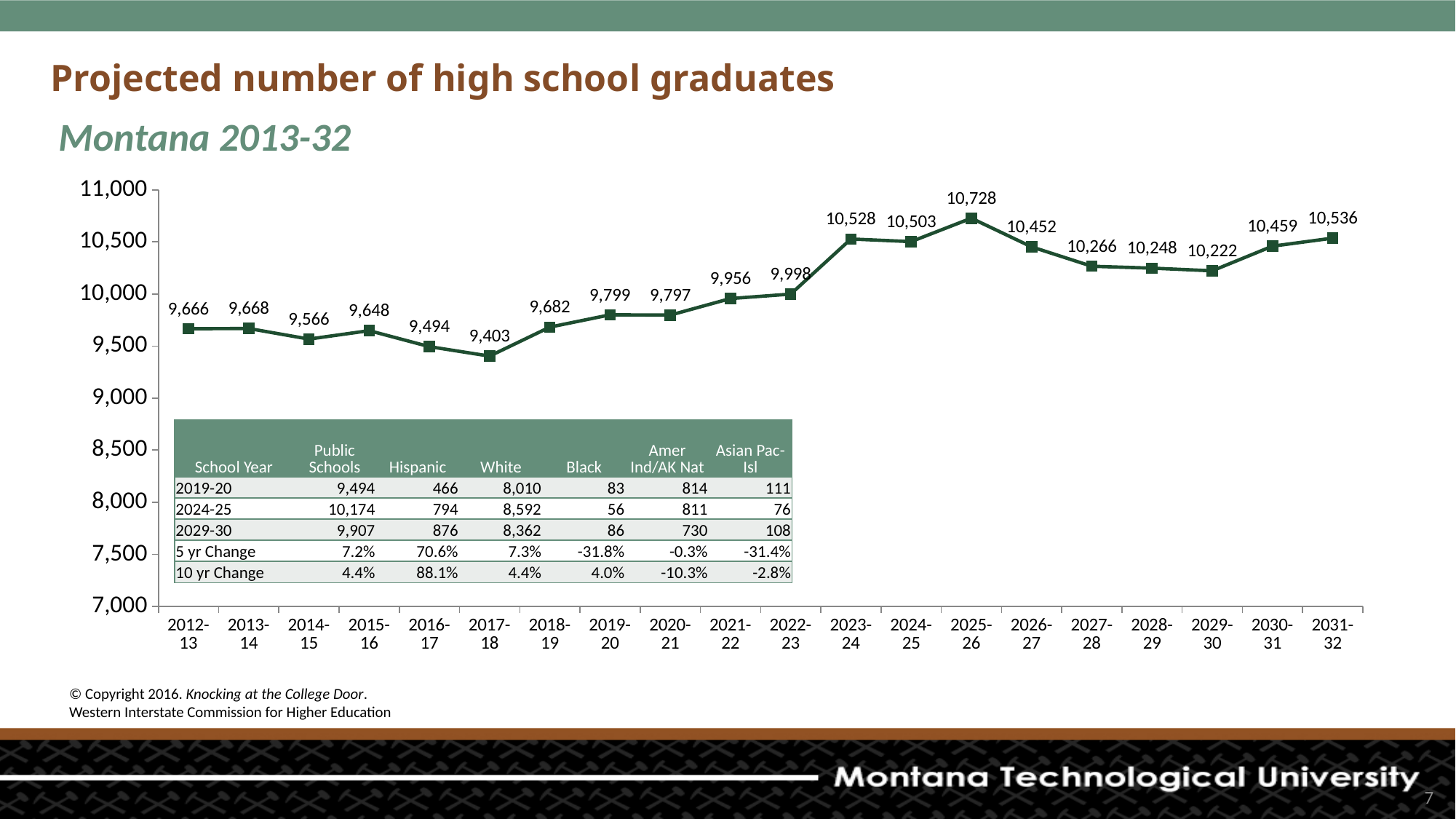
What is the difference between the highest value (2025-26) and the lowest value (2017-18) on the chart? 1,325 What is the projected number of high school graduates for 2017-18? 9,403 Overall, do the projected numbers of high school graduates rise or fall from 2012-13 to 2031-32? rise Which school year has the highest projected number of high school graduates? 2025-26 How much higher is the projected number for 2031-32 than for 2012-13? 870 Is the projected value for 2016-17 greater or less than 9,500? less Which school year has a larger projected number of graduates, 2023-24 or 2026-27? 2023-24 What is the projected number of high school graduates for 2025-26? 10,728 What is the projected number of high school graduates for 2031-32? 10,536 What type of chart is used to show the projected number of high school graduates? line chart Which school year has the lowest projected number of high school graduates? 2017-18 How many school years are plotted on the chart? 20